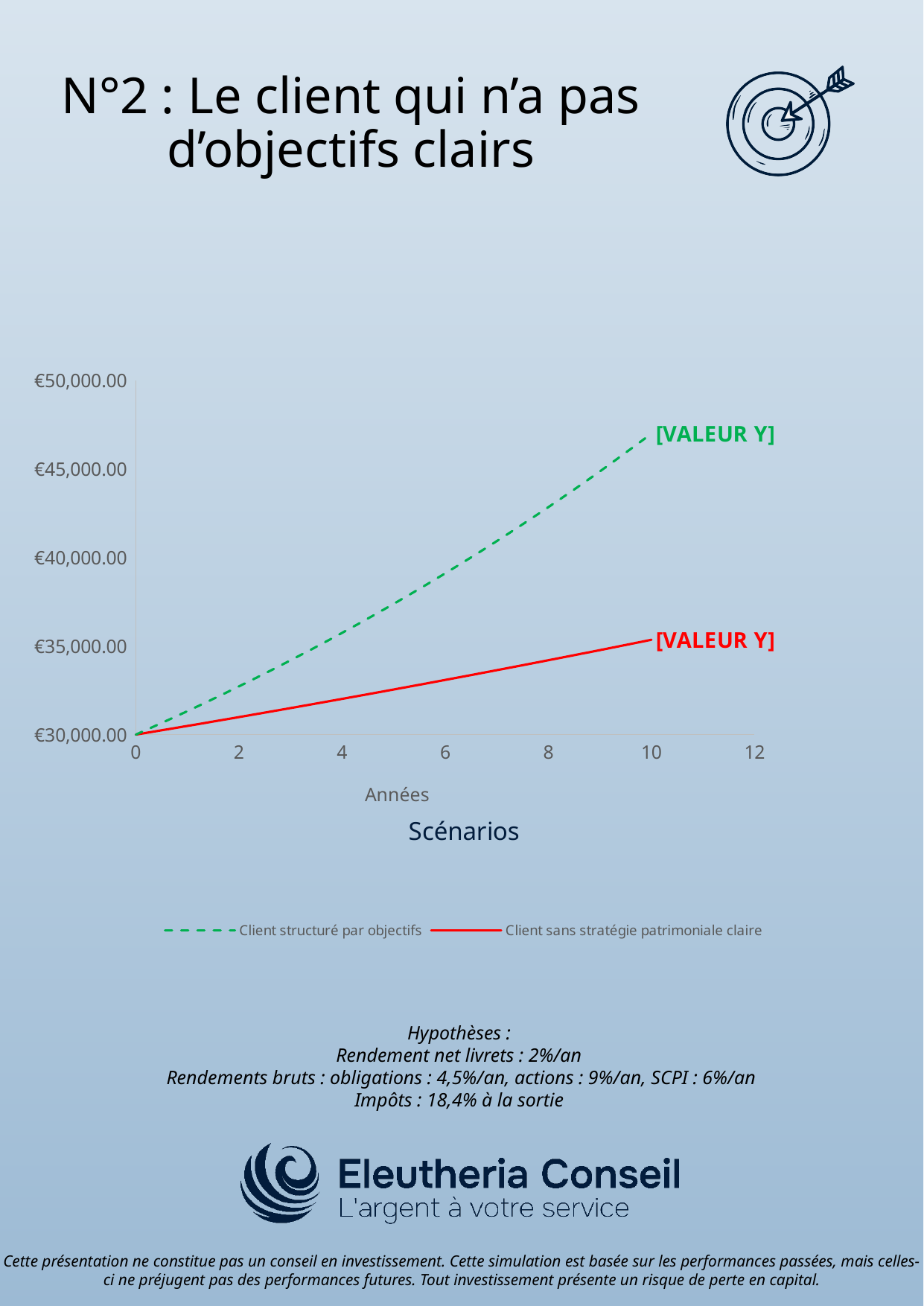
Which series has the lowest value at year 10? Client sans stratégie patrimoniale claire Is the value for 'Client sans stratégie patrimoniale claire' at year 10 greater or less than €40,000.00? less Which series has the higher value at year 10? Client structuré par objectifs Which series is drawn with a green dashed line? Client structuré par objectifs Is the value for 'Client structuré par objectifs' at year 10 greater or less than €45,000.00? greater Do the values of 'Client structuré par objectifs' rise or fall as the years increase? rise How many series does the chart legend list? 2 At year 0, what value do both series start from? €30,000.00 Do the values of 'Client sans stratégie patrimoniale claire' rise or fall along the x axis? rise What is the label of the x axis of the chart? Années What is the title of the chart? Scénarios What kind of chart is shown on the slide? line chart